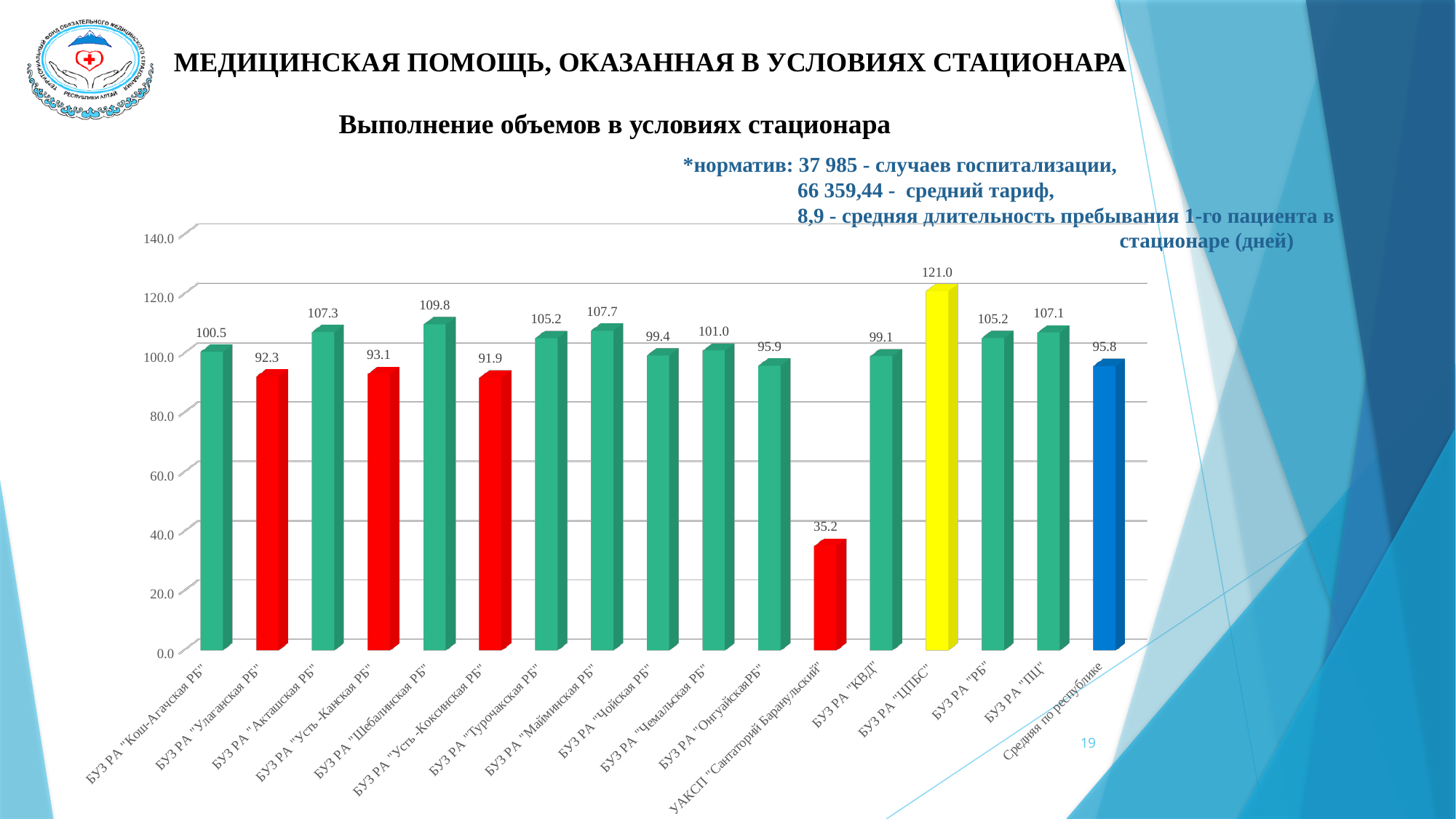
What is the difference between the values for БУЗ РА "ЦПБС" and БУЗ РА "Улаганская РБ"? 28.7 What is the value for БУЗ РА "Чемальская РБ"? 101.0 What colour is the bar for БУЗ РА "ЦПБС"? yellow What is the value for УАКСП "Санаторий Барнаульский"? 35.2 Which category has the lowest value? УАКСП "Санаторий Барнаульский" What is the value for Средняя по республике? 95.8 What is the value for БУЗ РА "Шебалинская РБ"? 109.8 What type of chart is shown on the slide? bar chart Is the value for БУЗ РА "Майминская РБ" greater or less than 100.0? greater Which is larger, the value for БУЗ РА "Акташская РБ" or БУЗ РА "Усть-Канская РБ"? БУЗ РА "Акташская РБ" Which category has the highest value? БУЗ РА "ЦПБС" How many categories are shown on the x axis? 17